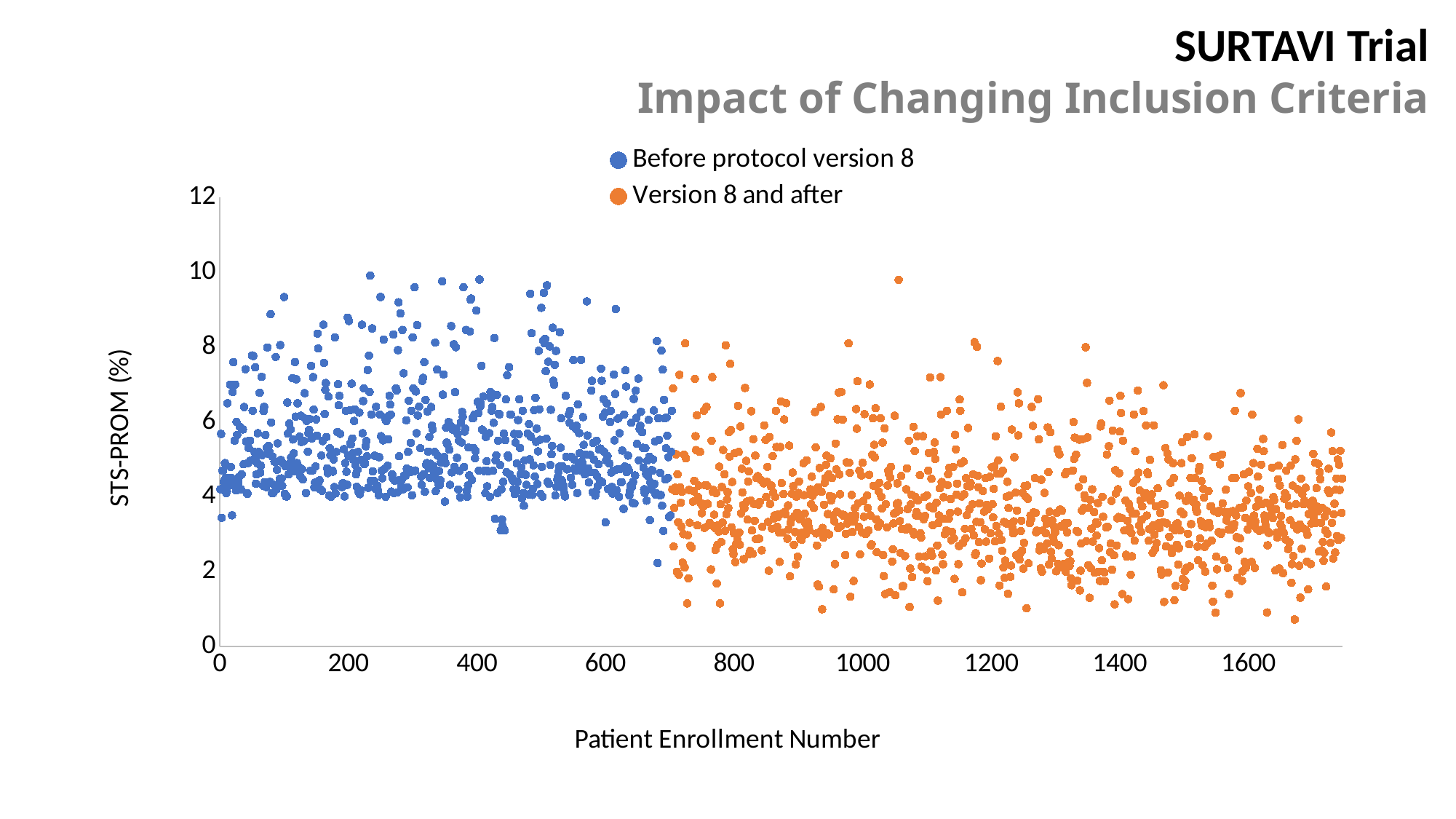
Which series is plotted in orange? Version 8 and after Which series generally has higher STS-PROM values, Before protocol version 8 or Version 8 and after? Before protocol version 8 Is the highest STS-PROM value in the Version 8 and after series greater or less than 8? greater What is the highest value shown on the y axis? 12 What is the label of the y axis? STS-PROM (%) What is the title of the chart? Impact of Changing Inclusion Criteria Do STS-PROM values generally rise or fall as the patient enrollment number increases? Fall Is the lowest STS-PROM value in the Version 8 and after series greater or less than 2? less Is the lowest STS-PROM value in the Before protocol version 8 series greater or less than 4? less What is the label of the x axis? Patient Enrollment Number How many series does the legend list? 2 What kind of chart is shown on the slide? Scatter plot